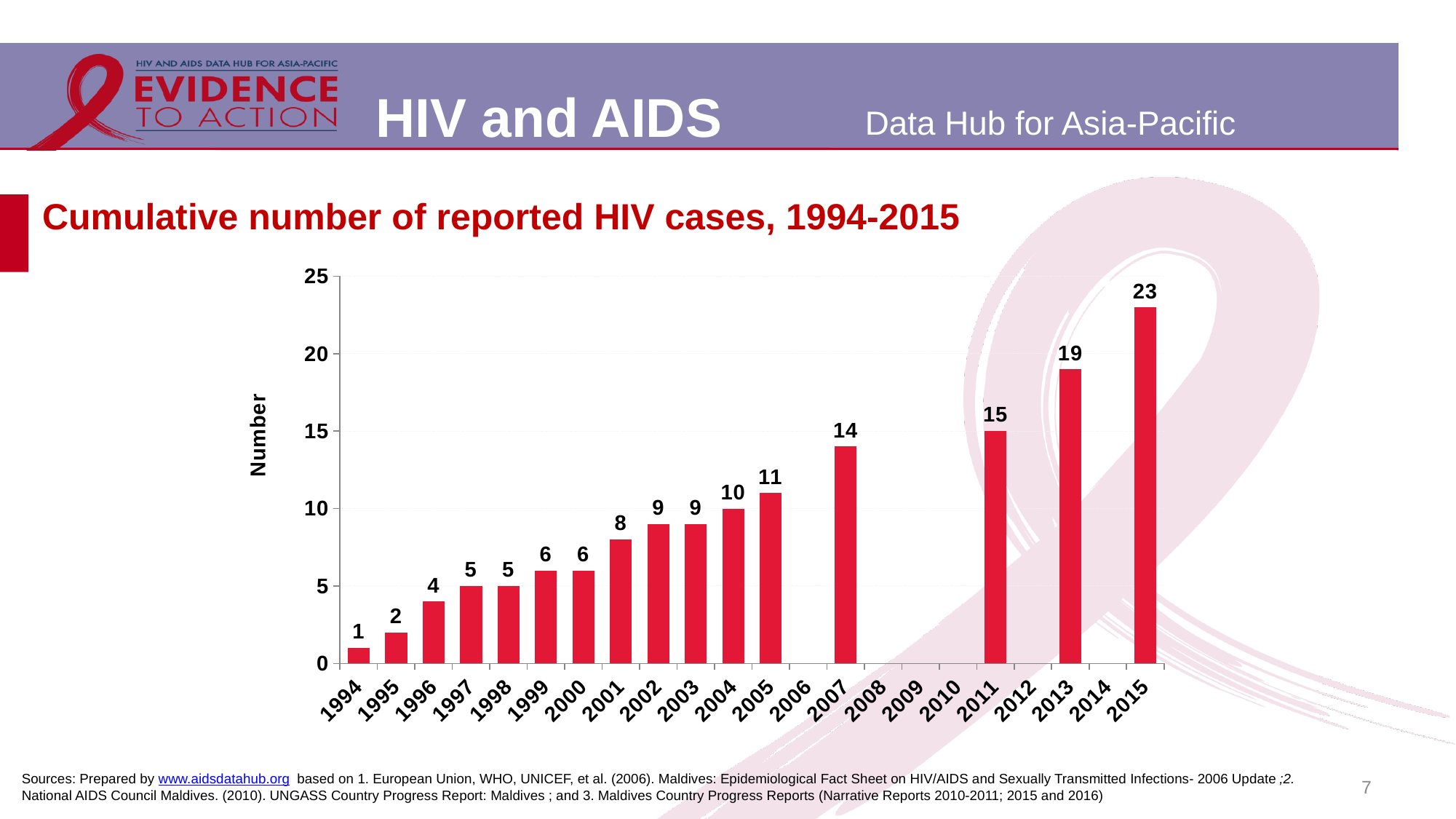
What is the cumulative number of reported HIV cases in 2001? 8 What is the cumulative number of reported HIV cases in 2015? 23 What is the label of the y axis of the chart? Number Do the cumulative numbers of reported HIV cases rise or fall from 1994 to 2015? rise How many years are labelled on the x axis of the chart? 22 What kind of chart is shown on the slide? bar chart Which year has the highest cumulative number of reported HIV cases? 2015 Is the value for 2013 greater or less than 15? greater Which year has the lowest cumulative number of reported HIV cases? 1994 What is the difference between the cumulative number of reported HIV cases in 2015 and in 2011? 8 What is the cumulative number of reported HIV cases in 2007? 14 Which year has a larger cumulative number of reported HIV cases, 2005 or 2013? 2013